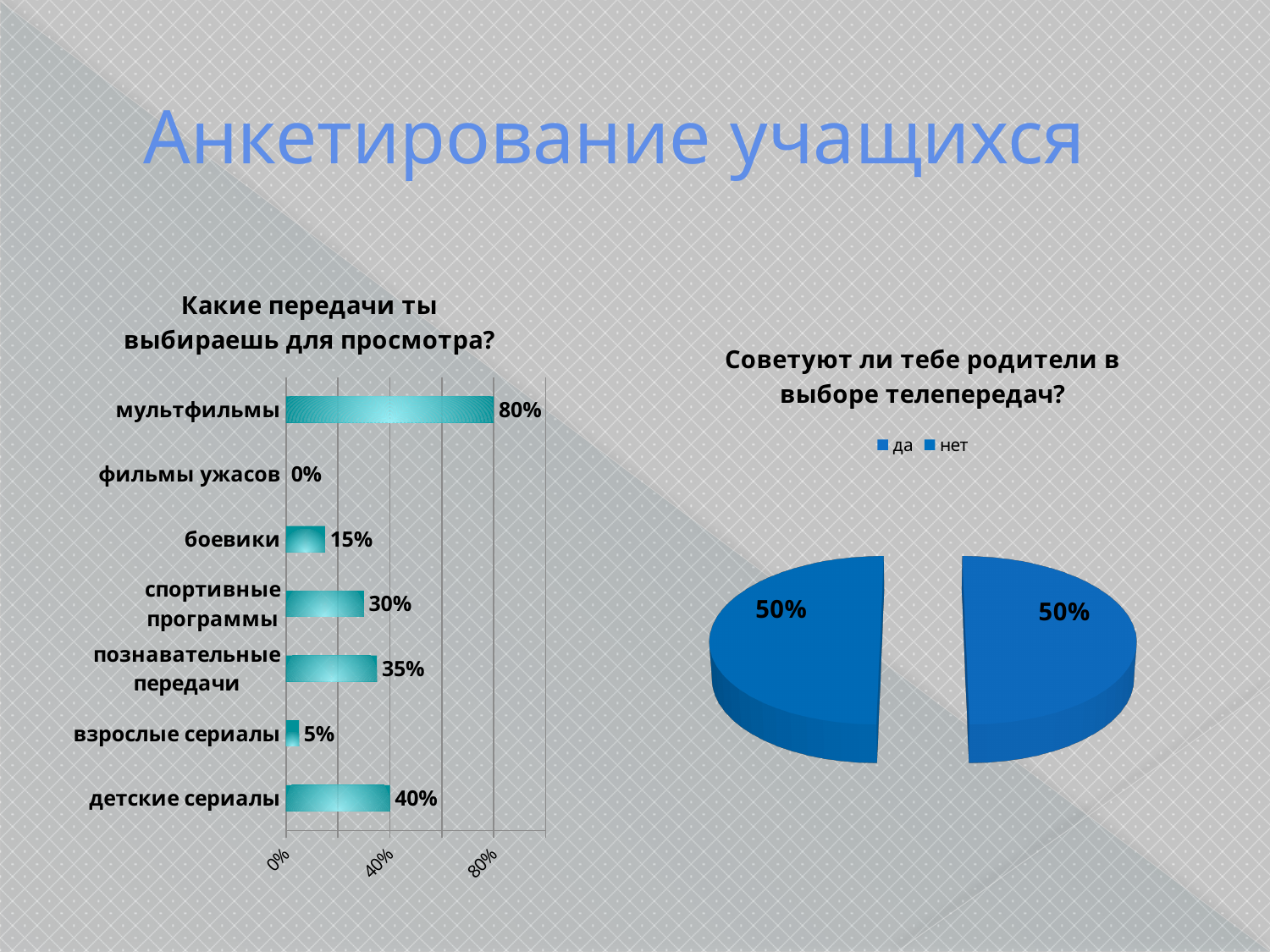
In the chart "Какие передачи ты выбираешь для просмотра?", what is the value for взрослые сериалы? 5% What kind of chart is "Какие передачи ты выбираешь для просмотра?"? bar chart In the chart "Советуют ли тебе родители в выборе телепередач?", what share of the pie is да? 50% In the chart "Какие передачи ты выбираешь для просмотра?", which category has the lowest value? фильмы ужасов In the chart "Какие передачи ты выбираешь для просмотра?", which is larger: спортивные программы or боевики? спортивные программы How many entries does the legend of the chart "Советуют ли тебе родители в выборе телепередач?" list? 2 In the chart "Какие передачи ты выбираешь для просмотра?", which category has the highest value? мультфильмы In the chart "Какие передачи ты выбираешь для просмотра?", what is the value for познавательные передачи? 35% In the chart "Какие передачи ты выбираешь для просмотра?", what is the difference between the values for мультфильмы and детские сериалы? 40% How many categories are shown in the chart "Какие передачи ты выбираешь для просмотра?"? 7 What kind of chart is "Советуют ли тебе родители в выборе телепередач?"? pie chart In the chart "Какие передачи ты выбираешь для просмотра?", what is the value for мультфильмы? 80%